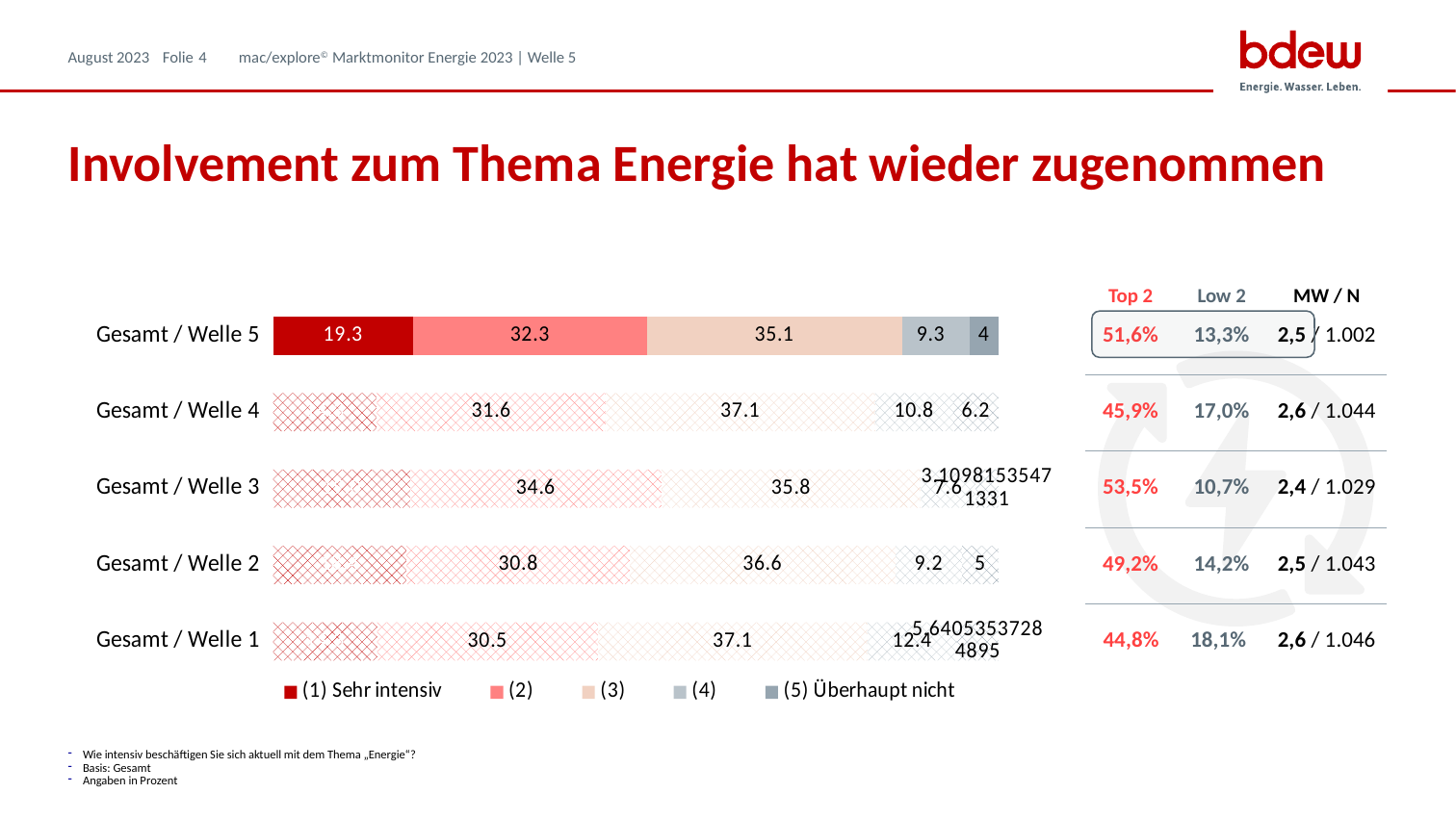
What is the first entry in the chart legend? (1) Sehr intensiv What is the value of the "(2)" segment for Gesamt / Welle 2? 30.8 What is the total of the stacked bar for Gesamt / Welle 5? 100 How many categories (waves) are plotted in the chart? 5 What kind of chart is shown on the slide? Stacked bar chart How many series does the chart legend list? 5 Which is larger: the "(3)" value for Gesamt / Welle 5 or for Gesamt / Welle 2? Gesamt / Welle 2 What is the difference between the "(2)" and "(1) Sehr intensiv" values for Gesamt / Welle 5? 13 Which wave has the lowest value for the "(4)" segment? Gesamt / Welle 3 Which wave has the highest value for the "(4)" segment? Gesamt / Welle 1 What is the value of the "(3)" segment for Gesamt / Welle 4? 37.1 What is the value of the "(1) Sehr intensiv" segment for Gesamt / Welle 5? 19.3